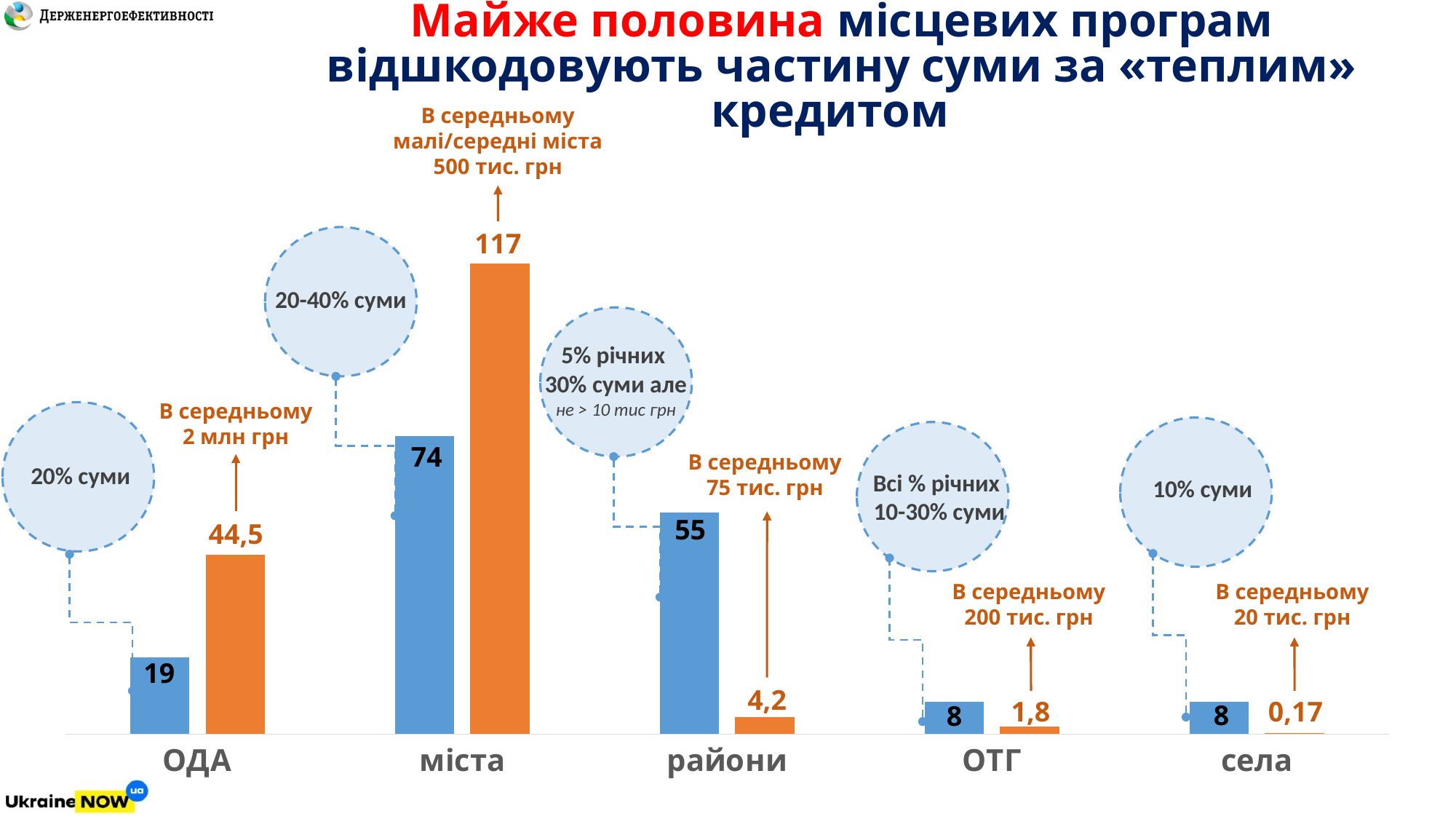
How many categories are shown on the x axis? 5 What is the difference between the blue bar for міста and the blue bar for райони? 19 What is the value of the blue bar for міста? 74 Which category has the highest orange bar? міста Which is larger for райони: the blue bar or the orange bar? the blue bar What is the value of the orange bar for ОДА? 44,5 What type of chart is shown on the slide? bar chart Which category has the highest blue bar? міста What is the value of the orange bar for села? 0,17 What is the difference between the orange bar for міста and the orange bar for ОДА? 72,5 What is the value of the blue bar for райони? 55 Which category has the lowest orange bar? села